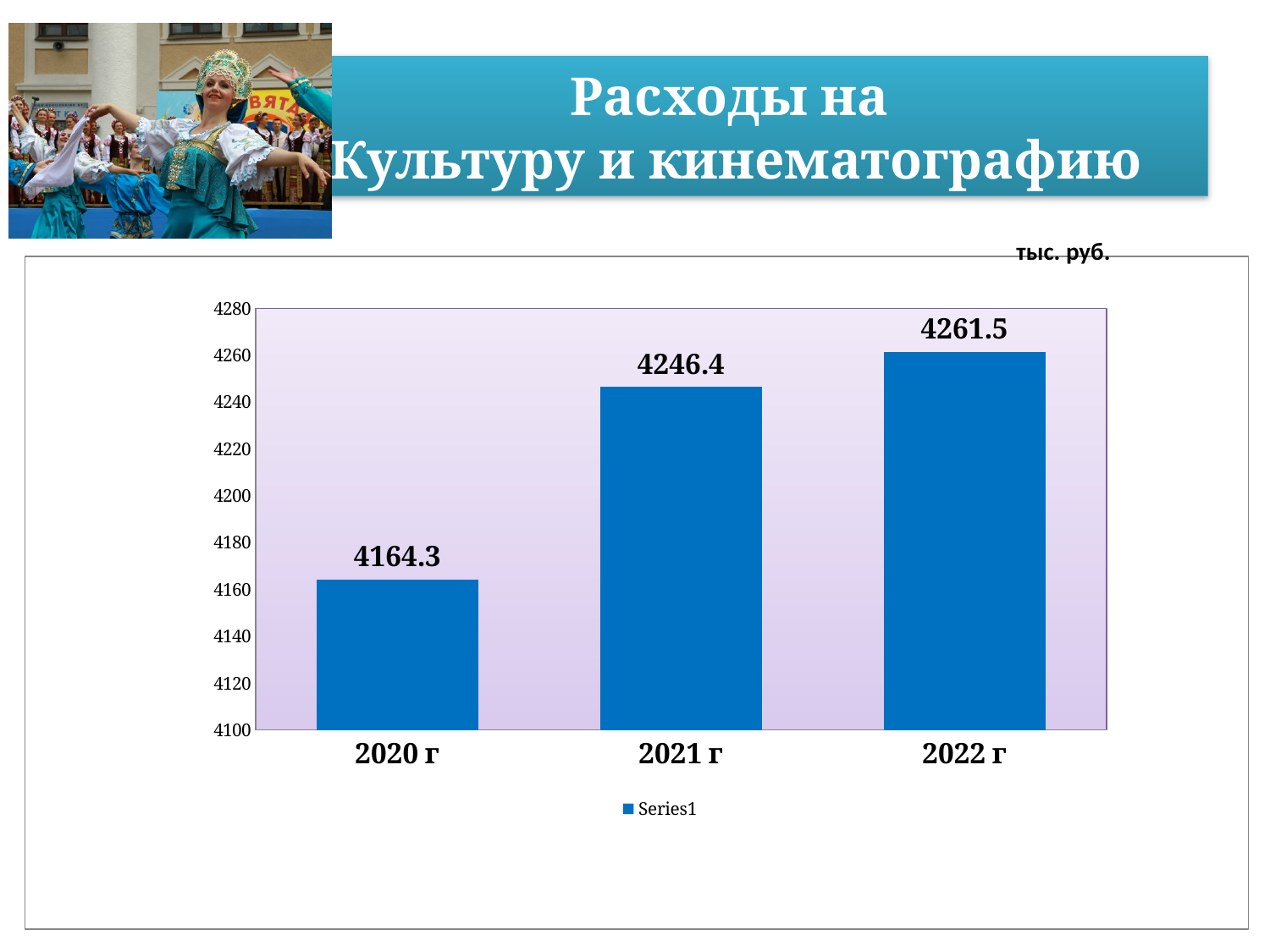
What is the value for 2020 г? 4164.3 Is the value for 2020 г greater or less than 4180? less What is the value for 2022 г? 4261.5 What is the value for 2021 г? 4246.4 Do the values rise or fall from 2020 г to 2022 г? rise What is the difference between the values for 2021 г and 2020 г? 82.1 What is the difference between the values for 2022 г and 2020 г? 97.2 Which year has the highest value? 2022 г What kind of chart is shown on the slide? bar chart Which is larger, the value for 2021 г or the value for 2020 г? 2021 г Which year has the lowest value? 2020 г How many years are shown on the chart? 3